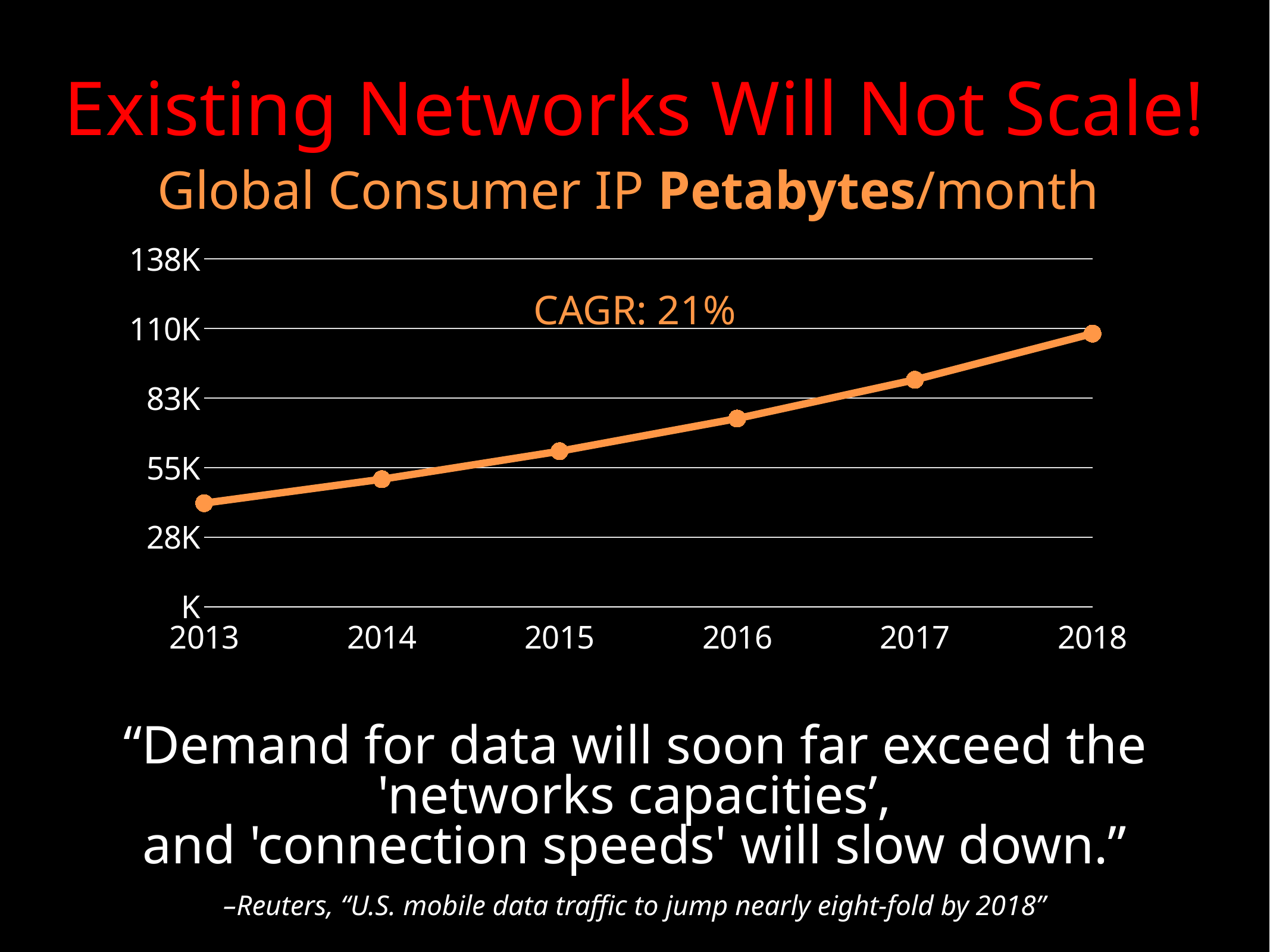
Which year has the lowest value? 2013 How many data points are plotted on the line? 6 Do the values rise or fall from 2013 to 2018? rise Is the value for 2013 greater or less than 55K? less What CAGR is stated on the chart? 21% Is the value for 2017 greater or less than 83K? greater Is the value for 2013 greater or less than 28K? greater What kind of chart is shown on the slide? line chart Which is larger, the value for 2016 or the value for 2014? 2016 Which year has the highest value? 2018